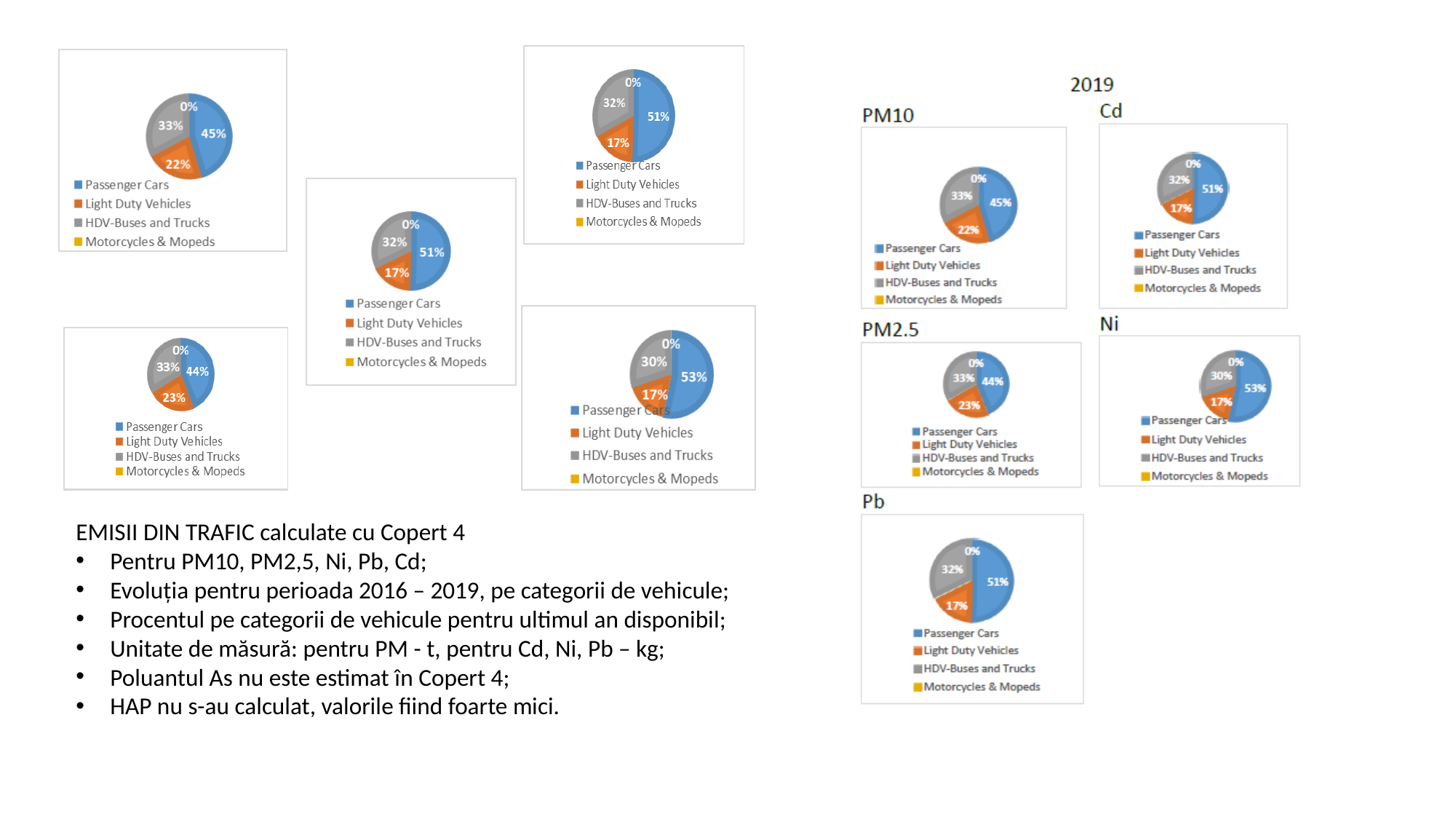
In the Ni pie chart, which category has the largest share? Passenger Cars In the PM10 pie chart, which category has the smallest share? Motorcycles & Mopeds In the PM2.5 pie chart, what is the difference between the Passenger Cars share and the Light Duty Vehicles share? 21% In the Pb pie chart, what share do Light Duty Vehicles have? 17% In the PM10 pie chart on the right side of the slide, what share do Passenger Cars have? 45% How many categories does the legend of the Pb pie chart list? 4 What kind of chart is used for the PM10 emissions breakdown? Pie chart Which year is shown above the group of pie charts on the right side of the slide? 2019 In the Cd pie chart, which is larger: the share of Light Duty Vehicles or the share of HDV-Buses and Trucks? HDV-Buses and Trucks In the Ni pie chart, what share do Passenger Cars have? 53% In the Cd pie chart, what share do HDV-Buses and Trucks have? 32% In the PM2.5 pie chart, what share do Light Duty Vehicles have? 23%